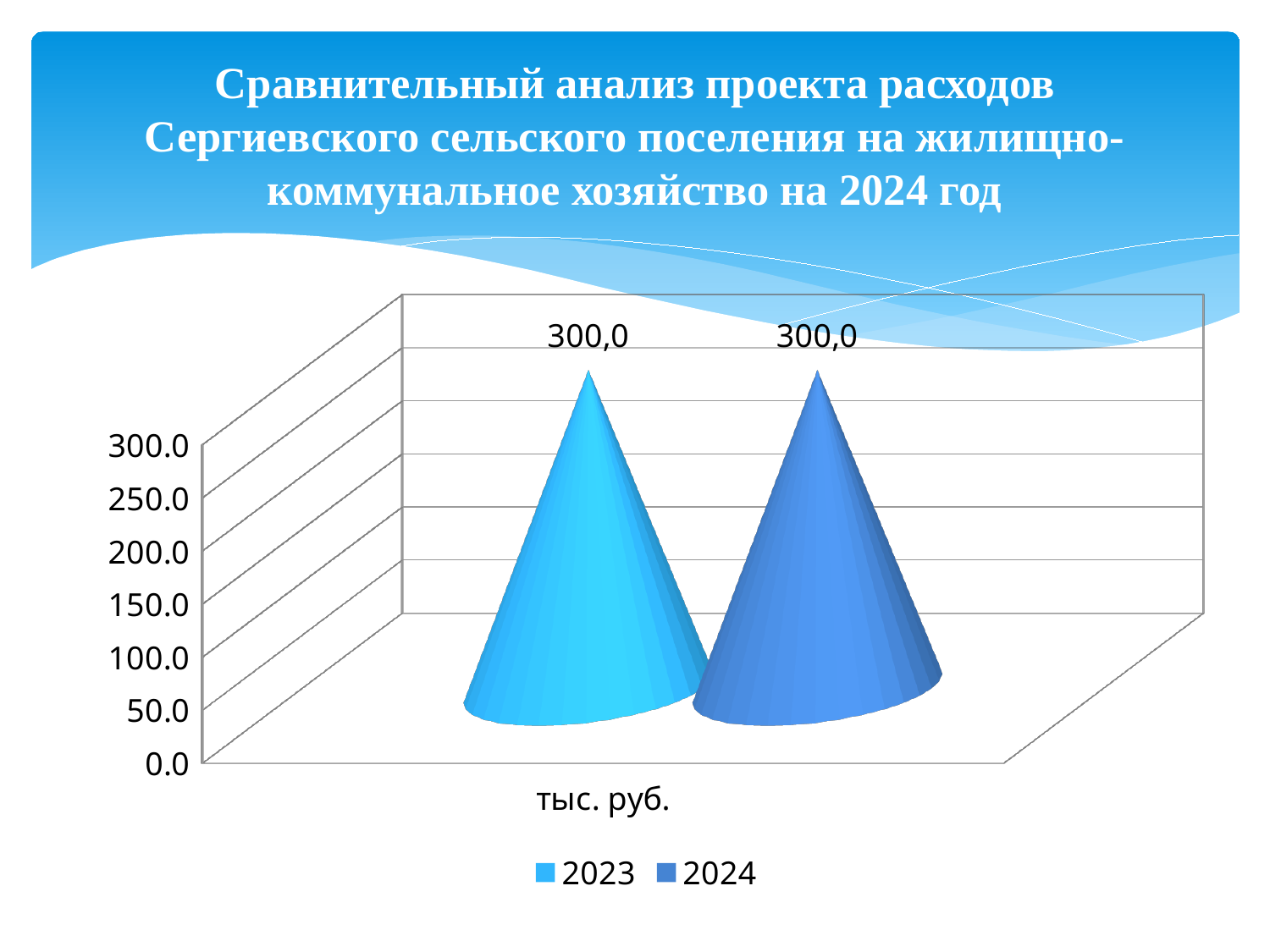
Is the value for 2024 larger than, smaller than, or equal to the value for 2023? equal How many categories are shown on the x axis of the chart? 1 Is the value for 2024 greater or less than 200? greater What is the value for the 2023 series on the chart? 300,0 What are the two entries listed in the chart legend? 2023 and 2024 How many series does the legend list? 2 Is the value for 2023 greater or less than 250? greater What is the category label shown under the bars on the x axis? тыс. руб. What is the difference between the 2024 value and the 2023 value? 0,0 What kind of chart is shown on the slide? bar chart What is the value for the 2024 series on the chart? 300,0